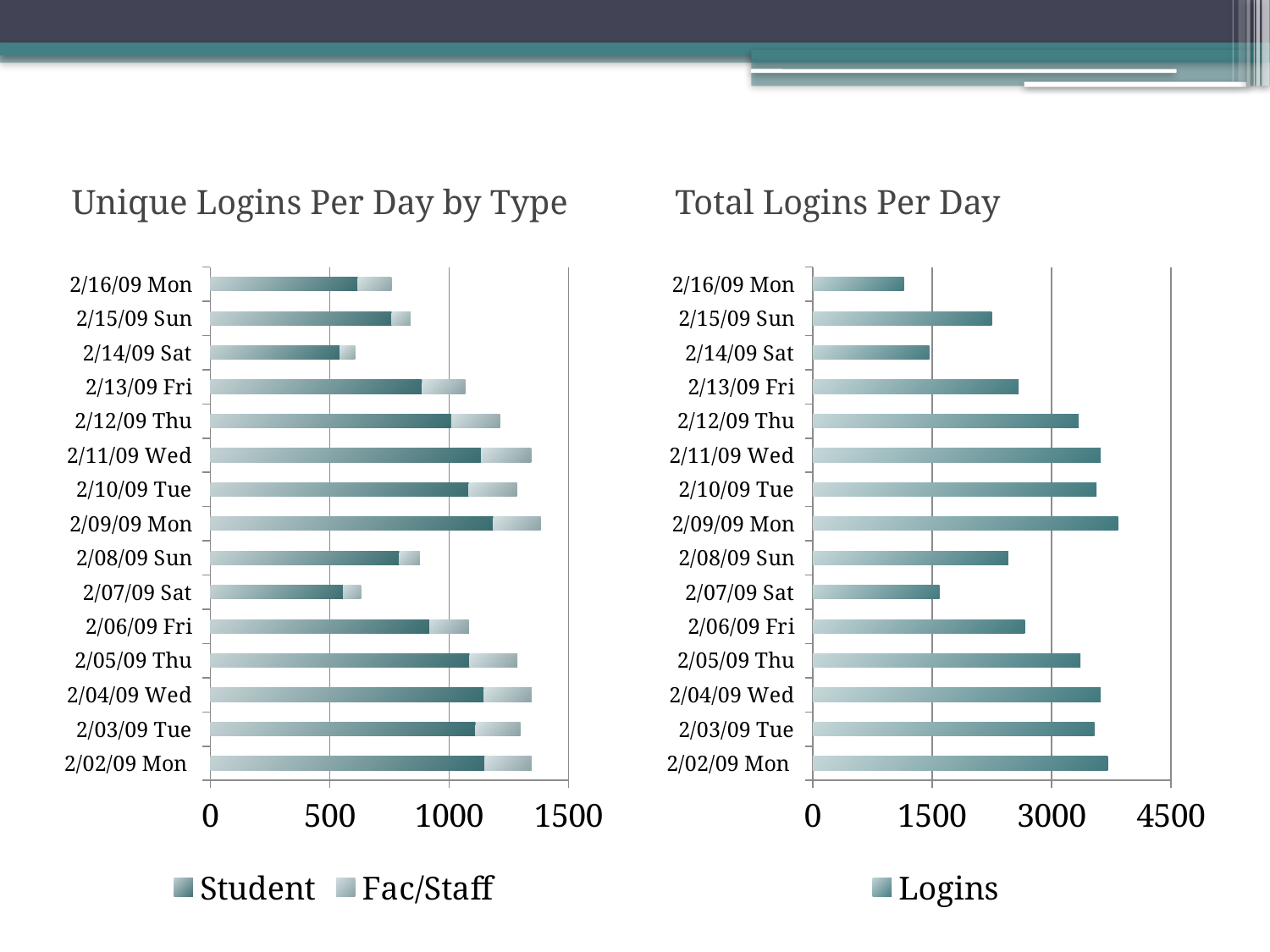
What kind of chart is the 'Total Logins Per Day' chart? Bar chart In the 'Total Logins Per Day' chart, is the value for 2/16/09 Mon greater or less than 1500? less In the 'Total Logins Per Day' chart, which day has more logins, 2/15/09 Sun or 2/14/09 Sat? 2/15/09 Sun In the 'Total Logins Per Day' chart, which day has the highest number of logins? 2/09/09 Mon How many days are shown on the 'Total Logins Per Day' chart? 15 In the 'Total Logins Per Day' chart, is the value for 2/09/09 Mon greater or less than 3000? greater In the 'Unique Logins Per Day by Type' chart, what are the two series named in the legend? Student and Fac/Staff What kind of chart is the 'Unique Logins Per Day by Type' chart? Stacked bar chart In the 'Unique Logins Per Day by Type' chart, is the Student value for 2/09/09 Mon greater or less than 1000? greater In the 'Total Logins Per Day' chart, which day has the lowest number of logins? 2/16/09 Mon How many series does the legend of the 'Unique Logins Per Day by Type' chart list? 2